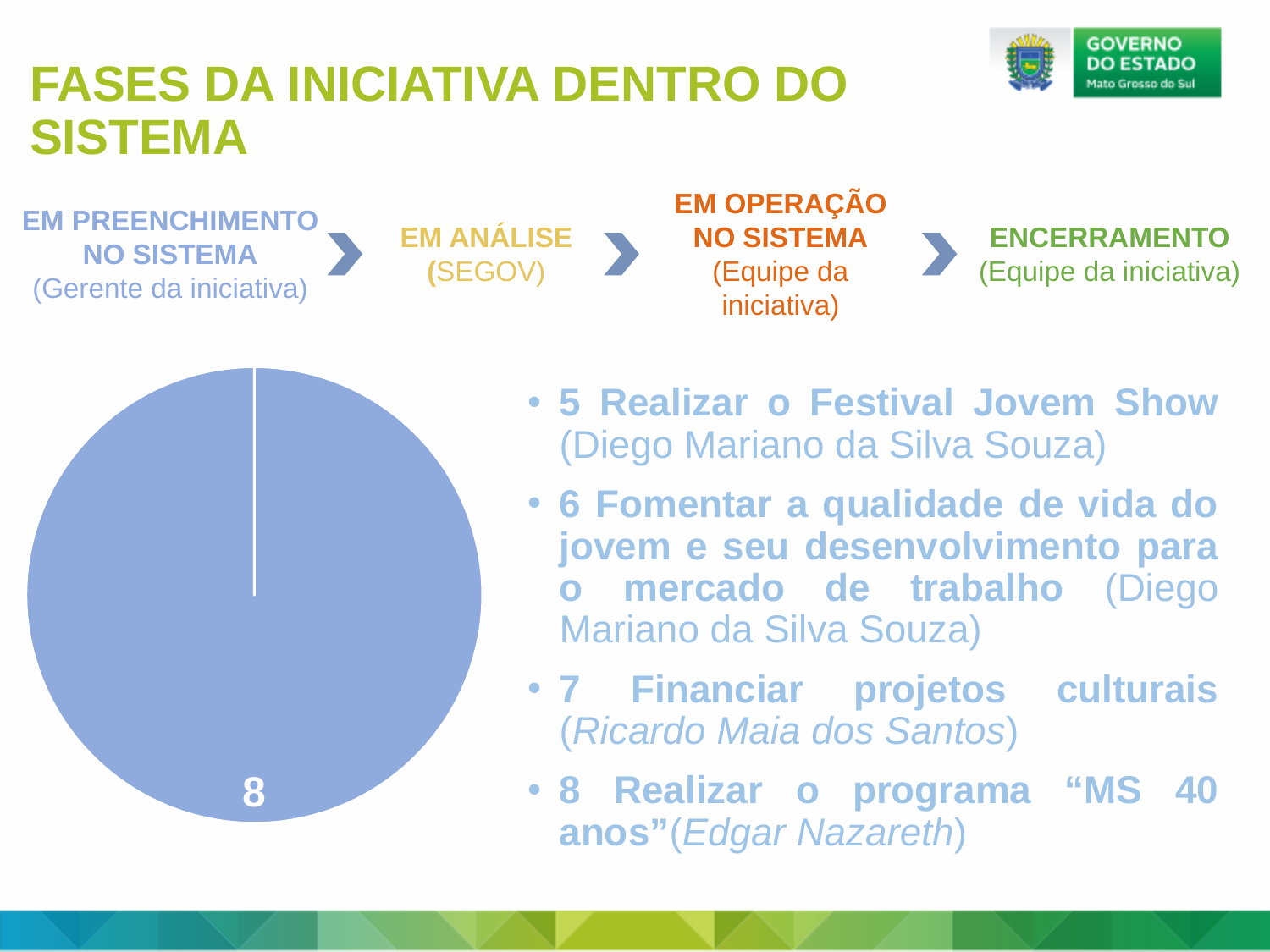
Does the pie chart on the slide display a legend? No What colour is the slice of the pie chart? blue What data label is printed on the pie chart's slice? 8 How many slices does the pie chart on the slide have? 1 What kind of chart is shown on the left side of the slide? pie chart What share of the pie chart does its single slice occupy? 100%